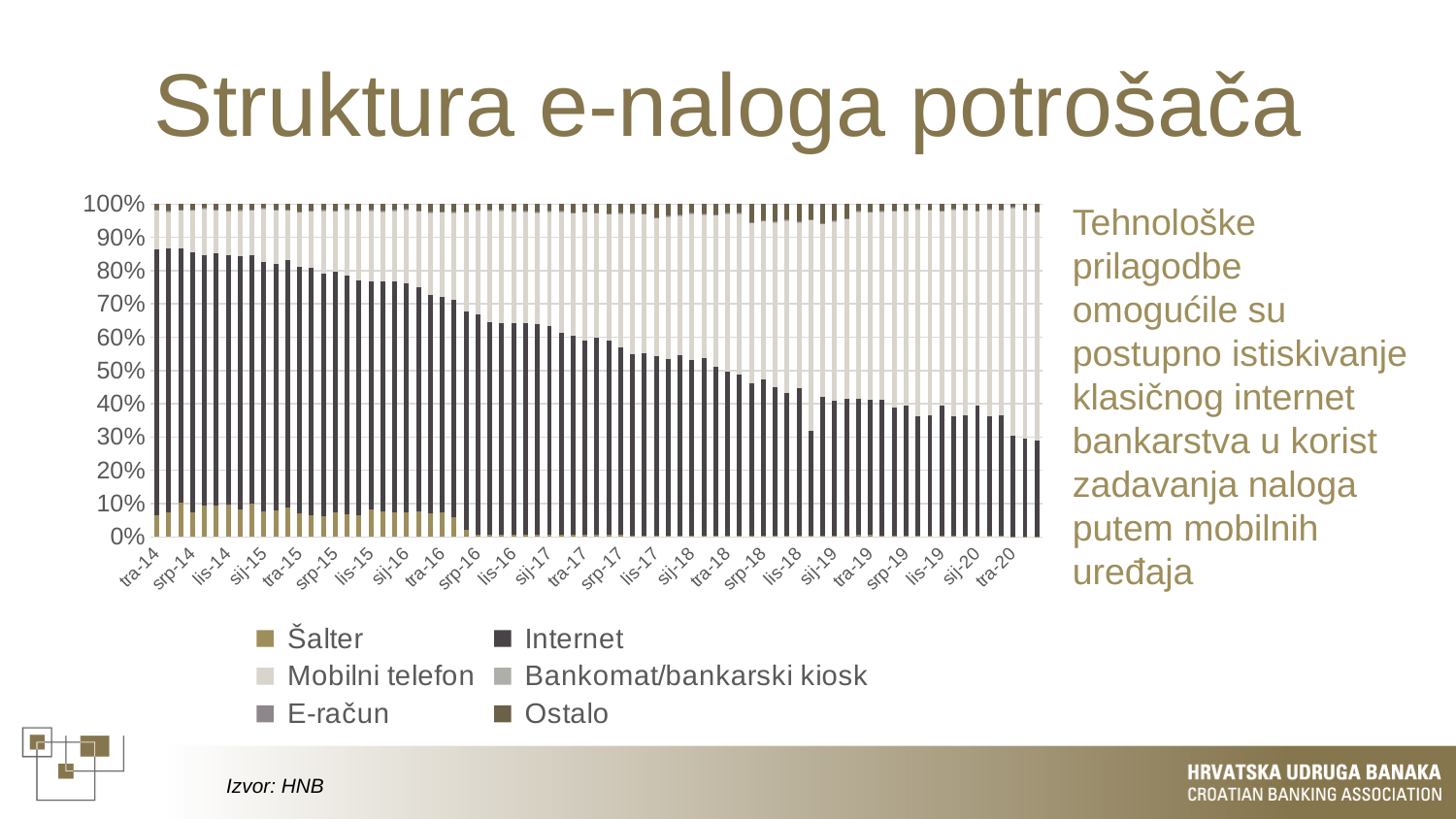
Is the cumulative top of the Internet segment in the tra-14 bar greater or less than 80%? greater Is the Internet share in the tra-20 bar greater or less than 40%? less Is the Šalter share in the tra-16 bar greater or less than 10%? less Which source is cited for the chart data? HNB Does the share of the Mobilni telefon series rise or fall along the x axis from tra-14 to tra-20? Rise Does the share of the Internet series rise or fall along the x axis from tra-14 to tra-20? Fall Which series has the largest share in the tra-20 bar? Mobilni telefon Which series has the largest share in the tra-14 bar? Internet What is the title of the slide containing the chart? Struktura e-naloga potrošača In the tra-20 bar, which is larger: the Internet share or the Mobilni telefon share? Mobilni telefon How many series does the chart legend list? 6 What kind of chart is shown on the slide? Stacked bar chart